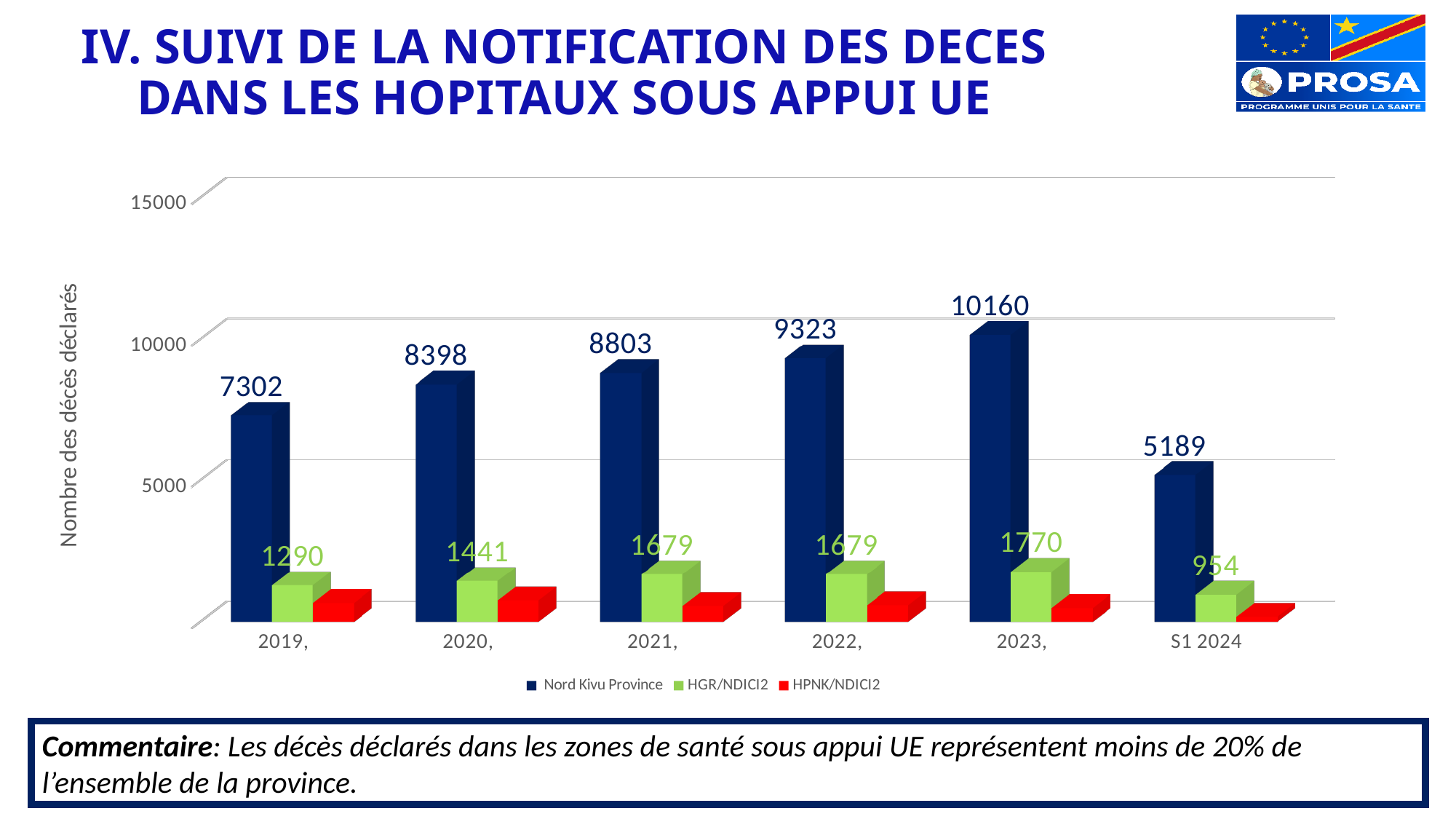
What is the value for HGR/NDICI2 in 2020? 1441 What is the value for Nord Kivu Province in 2023? 10160 What is the value for Nord Kivu Province in S1 2024? 5189 What kind of chart is shown on the slide? bar chart In which year is the Nord Kivu Province value highest? 2023 What is the difference between the Nord Kivu Province and HGR/NDICI2 values in 2022? 7644 How many series does the legend list? 3 In which period is the HGR/NDICI2 value lowest? S1 2024 Is the value for HPNK/NDICI2 in 2021 greater or less than 5000? less Which is larger, the HGR/NDICI2 value in 2021 or in 2023? 2023 What is the difference between the Nord Kivu Province values for 2023 and 2019? 2858 How many periods are shown on the x axis? 6